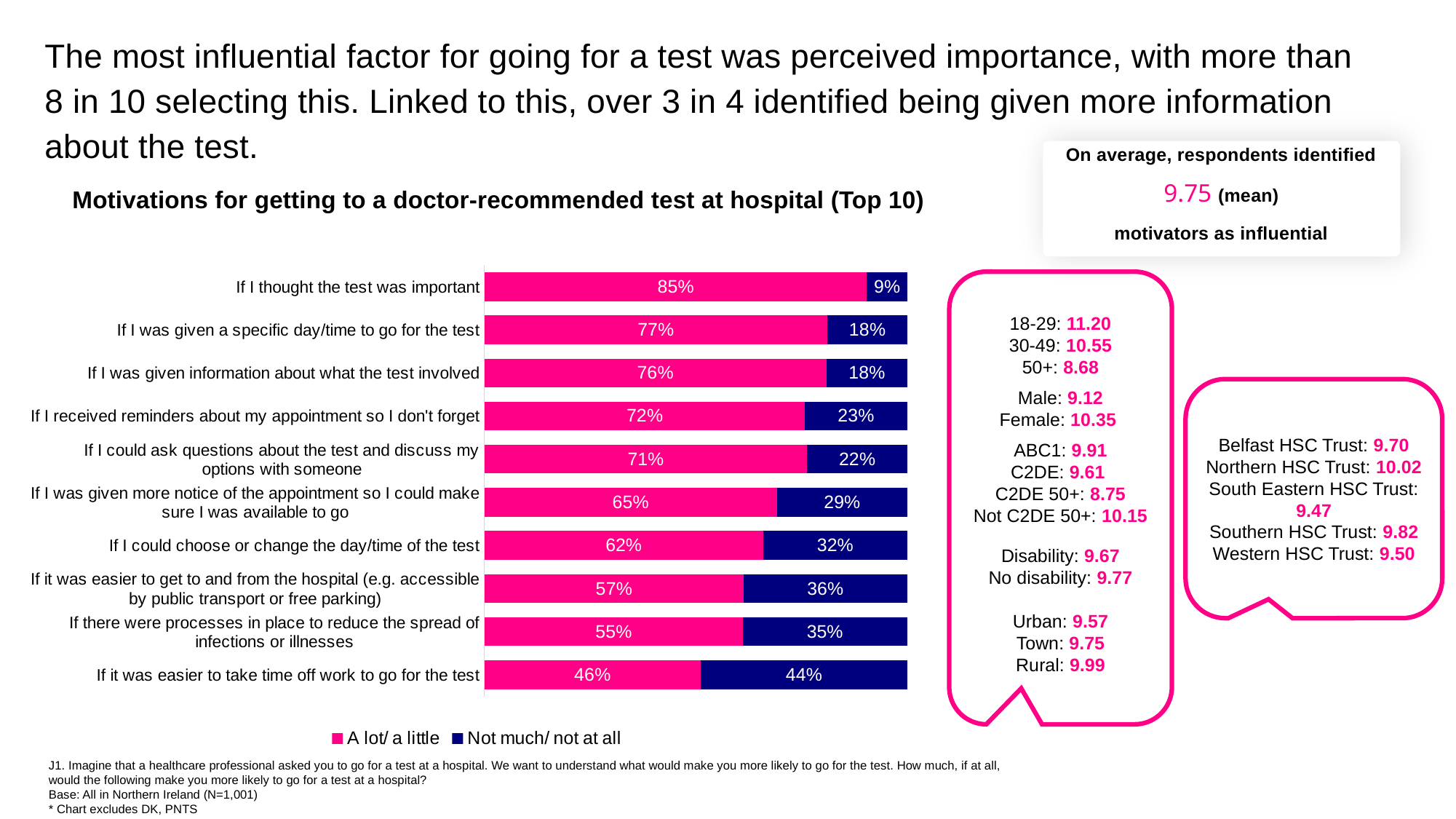
What percentage of respondents said 'A lot/ a little' for 'If I thought the test was important'? 85% How many motivations are shown in the chart? 10 What is the 'A lot/ a little' value for 'If I received reminders about my appointment so I don't forget'? 72% What is the 'Not much/ not at all' value for 'If it was easier to take time off work to go for the test'? 44% What kind of chart is shown on the slide? Stacked bar chart Which has a larger 'Not much/ not at all' value: 'If it was easier to get to and from the hospital' or 'If I was given more notice of the appointment'? If it was easier to get to and from the hospital Which motivation has the highest 'A lot/ a little' percentage? If I thought the test was important What is the total of the two segments for 'If I was given information about what the test involved'? 94% How many series does the legend list? 2 What is the title of the chart? Motivations for getting to a doctor-recommended test at hospital (Top 10) Which motivation has the lowest 'A lot/ a little' percentage? If it was easier to take time off work to go for the test What is the difference between the 'A lot/ a little' values for 'If I was given a specific day/time to go for the test' and 'If I could choose or change the day/time of the test'? 15%